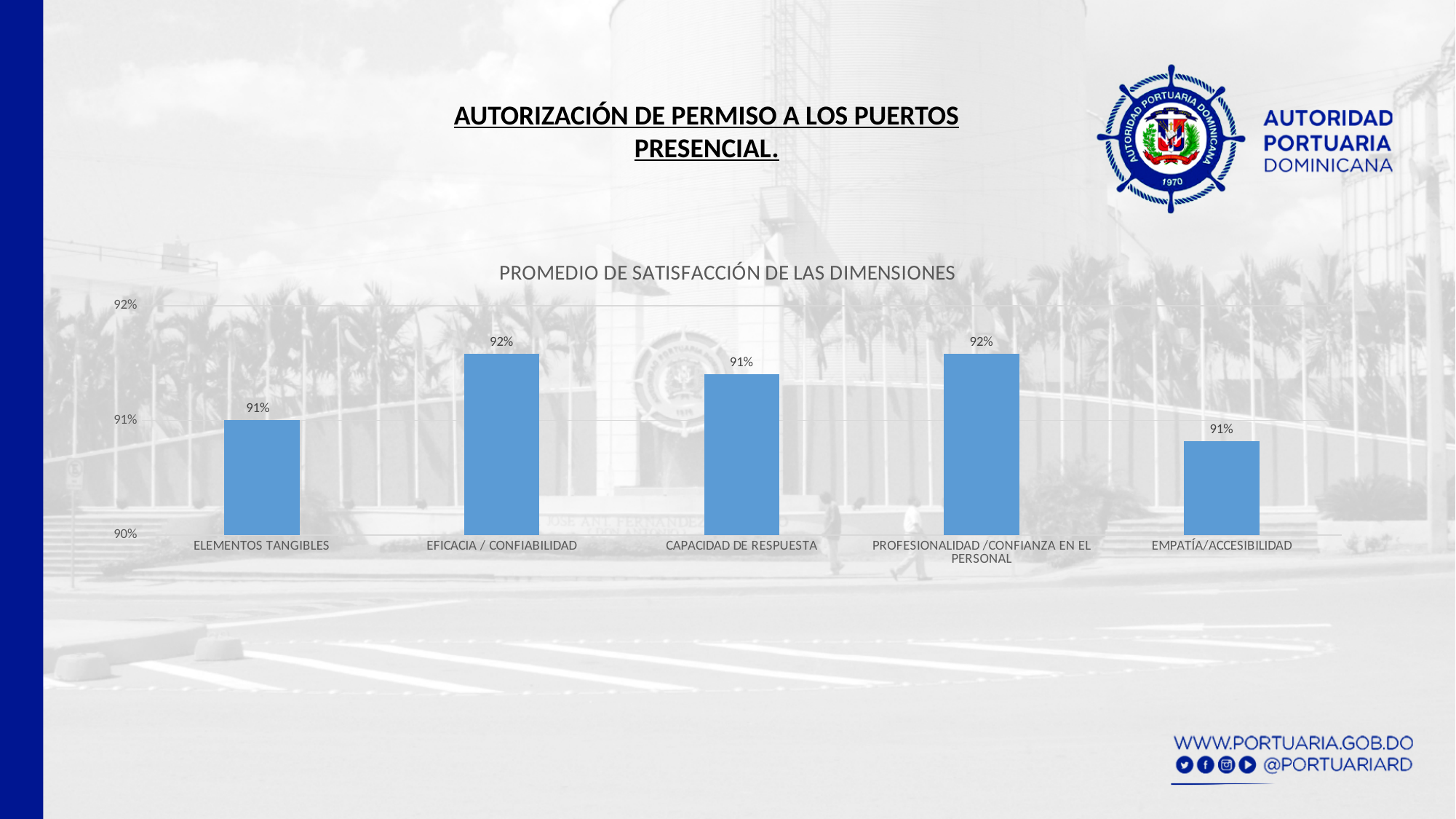
What is the value for CAPACIDAD DE RESPUESTA? 91% What is the value for EMPATÍA/ACCESIBILIDAD? 91% What is the difference between the value for EFICACIA / CONFIABILIDAD and the value for CAPACIDAD DE RESPUESTA? 1% Which is larger, the value for EFICACIA / CONFIABILIDAD or the value for ELEMENTOS TANGIBLES? EFICACIA / CONFIABILIDAD Is the value for EMPATÍA/ACCESIBILIDAD greater or less than 92%? less What kind of chart is shown on the slide? bar chart What is the value for PROFESIONALIDAD /CONFIANZA EN EL PERSONAL? 92% How many categories are shown on the x axis of the chart? 5 What is the title of the chart? PROMEDIO DE SATISFACCIÓN DE LAS DIMENSIONES What is the value for ELEMENTOS TANGIBLES? 91% What is the value for EFICACIA / CONFIABILIDAD? 92% Which is larger, the value for PROFESIONALIDAD /CONFIANZA EN EL PERSONAL or the value for EMPATÍA/ACCESIBILIDAD? PROFESIONALIDAD /CONFIANZA EN EL PERSONAL